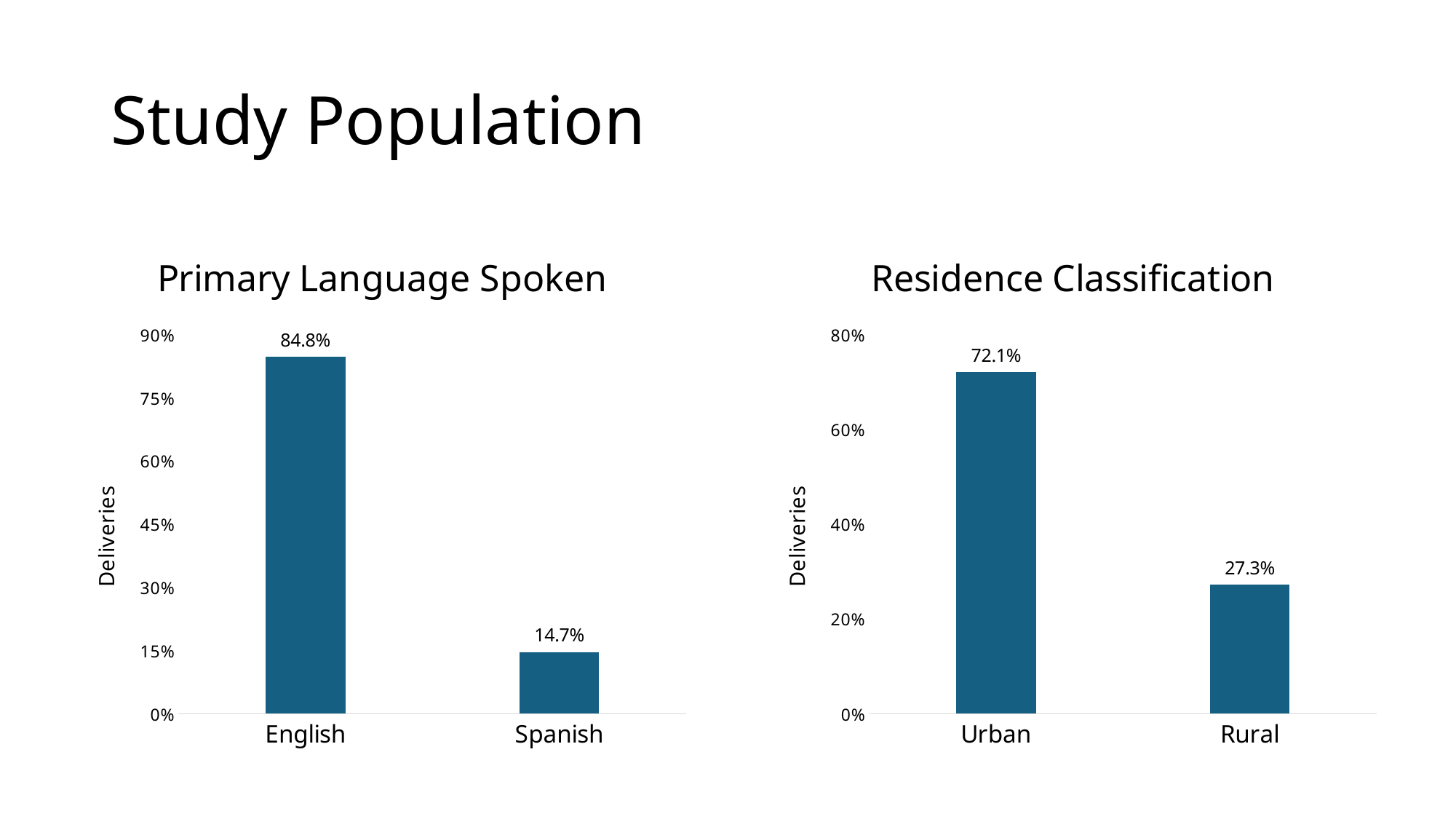
In the Residence Classification chart, what is the value for Urban? 72.1% In the Primary Language Spoken chart, what is the value for Spanish? 14.7% In the Residence Classification chart, which category has the lowest value? Rural In the Primary Language Spoken chart, what is the difference between the English and Spanish values? 70.1% What is the y-axis label on the Primary Language Spoken chart? Deliveries In the Residence Classification chart, what is the difference between the Urban and Rural values? 44.8% In the Primary Language Spoken chart, which category has the highest value? English In the Residence Classification chart, which is larger, Urban or Rural? Urban In the Primary Language Spoken chart, how many categories are shown? 2 What kind of chart is the Residence Classification chart? Bar chart In the Residence Classification chart, what is the value for Rural? 27.3% In the Primary Language Spoken chart, what is the value for English? 84.8%